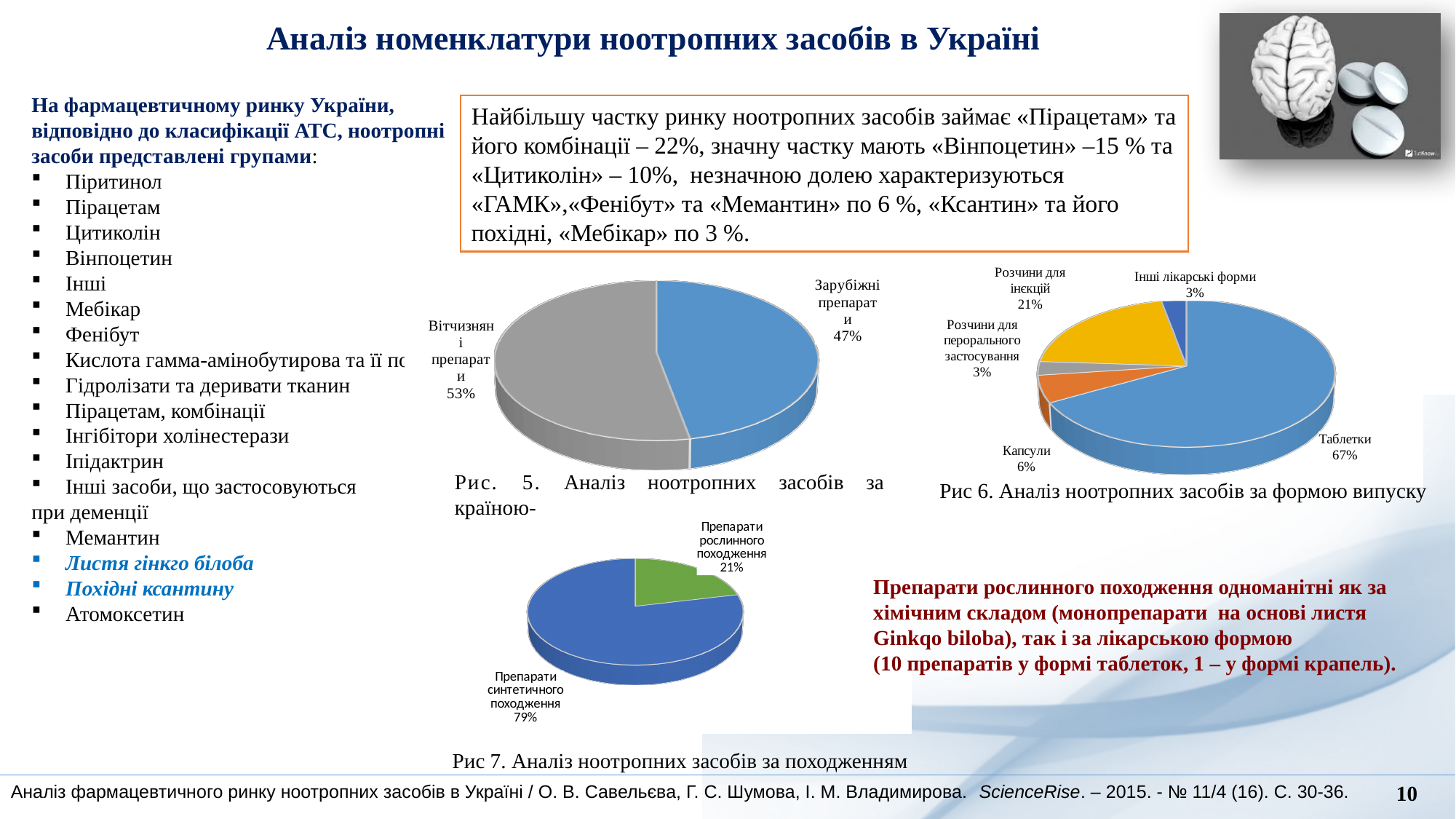
In the pie chart captioned Рис. 5, which slice is larger: Вітчизняні препарати or Зарубіжні препарати? Вітчизняні препарати In the pie chart captioned Рис. 6, what share do Розчини для інєкцій have? 21% What type of chart is used for Рис. 7 (analysis by origin)? Pie chart In the pie chart captioned Рис. 5, what is the difference in percentage points between Вітчизняні препарати and Зарубіжні препарати? 6 percentage points In the pie chart captioned Рис. 7, what share do Препарати рослинного походження have? 21% In the pie chart captioned Рис. 6, what share do Капсули have? 6% In the pie chart captioned Рис. 5 (analysis by country), what share do Зарубіжні препарати have? 47% In the pie chart captioned Рис. 6, which dosage form has the largest share? Таблетки In the pie chart captioned Рис. 7 (analysis by origin), what share do Препарати синтетичного походження have? 79% How many slices does the pie chart captioned Рис. 6 have? 5 In the pie chart captioned Рис. 6 (analysis by dosage form), what share do Таблетки have? 67% In the pie chart captioned Рис. 5 (analysis by country), what share do Вітчизняні препарати have? 53%